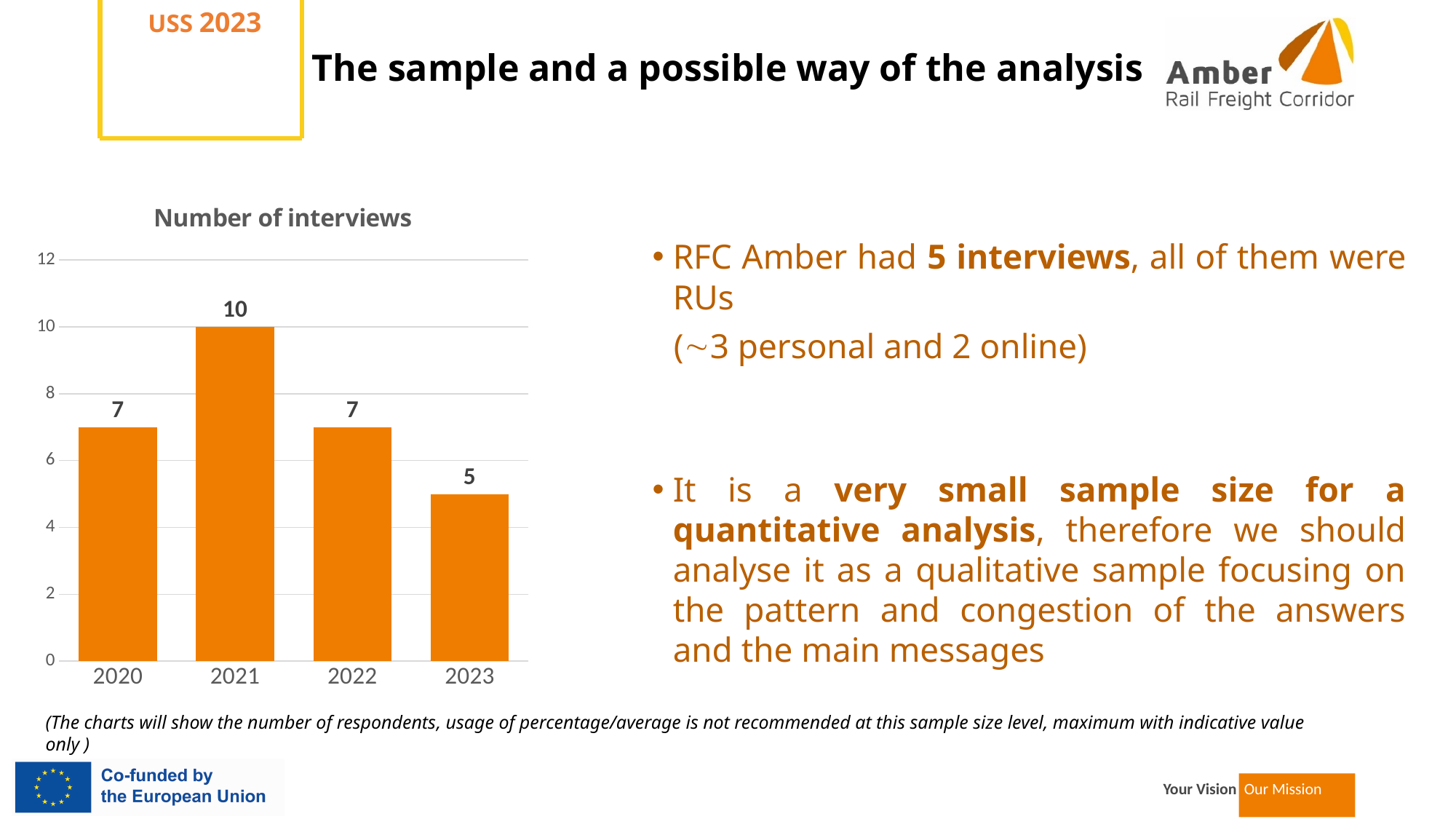
What is the number of interviews for 2023? 5 What is the difference in the number of interviews between 2021 and 2023? 5 Do the number of interviews rise or fall from 2021 to 2023? Fall Which year had more interviews, 2022 or 2023? 2022 How many years are shown on the x axis of the chart? 4 What is the title of the chart? Number of interviews Which year has the lowest number of interviews? 2023 What is the number of interviews for 2021? 10 Which year has the highest number of interviews? 2021 Is the value for 2021 greater or less than 8? greater What kind of chart is shown on the slide? Bar chart What is the number of interviews for 2020? 7